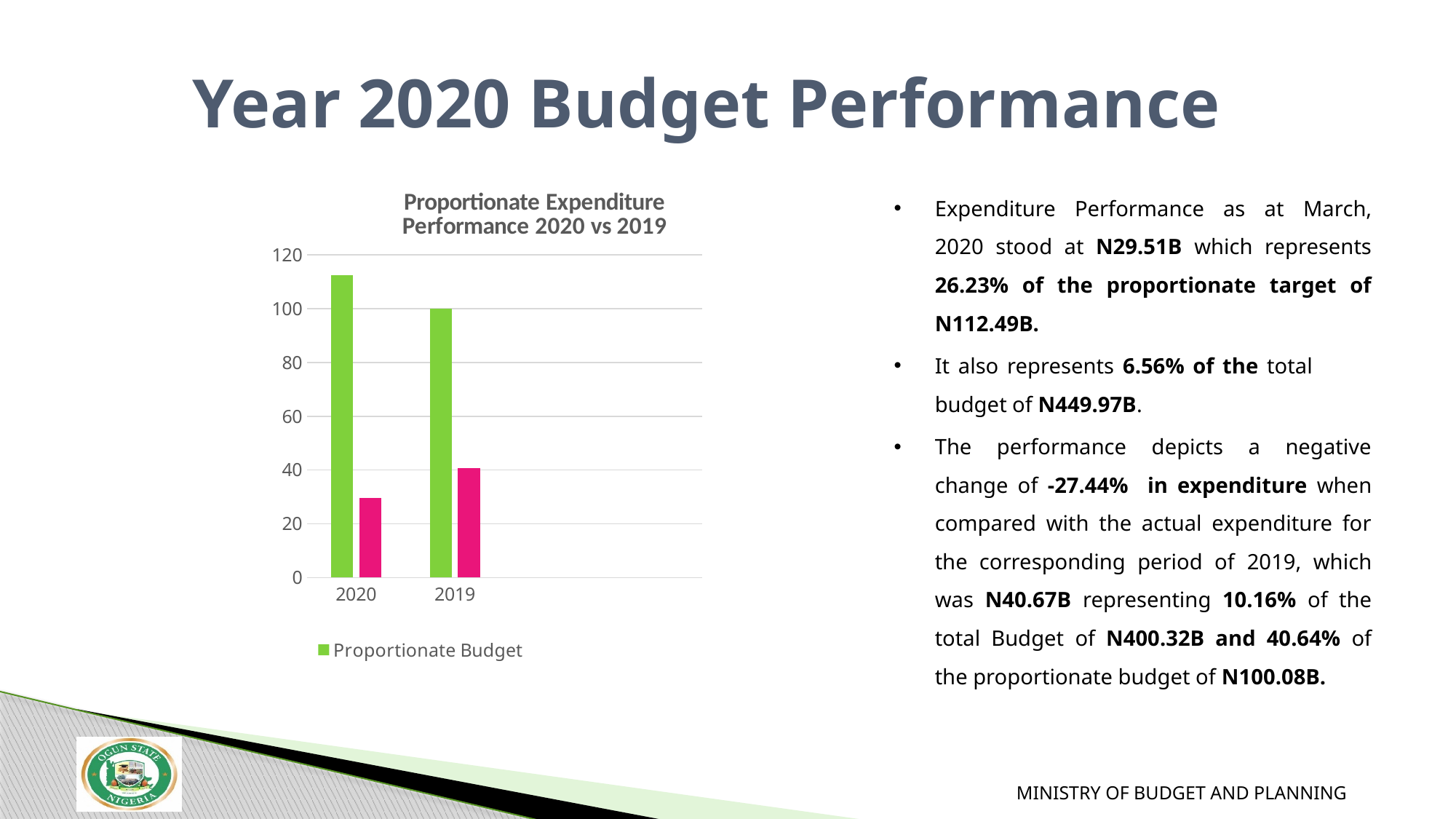
How many series does the chart's legend list? 1 What is the title of the chart? Proportionate Expenditure Performance 2020 vs 2019 Which year has the higher Proportionate Budget bar, 2020 or 2019? 2020 Is the value of the pink bar for 2019 greater or less than 60? less Is the Proportionate Budget value for 2020 greater or less than 100? greater What colour are the Proportionate Budget bars in the chart? Green Which year has the taller pink bar, 2020 or 2019? 2019 Is the Proportionate Budget value for 2019 greater or less than 80? greater How many categories are shown on the x axis of the chart? 2 Which category has the highest Proportionate Budget value? 2020 What kind of chart is shown on the slide? Bar chart